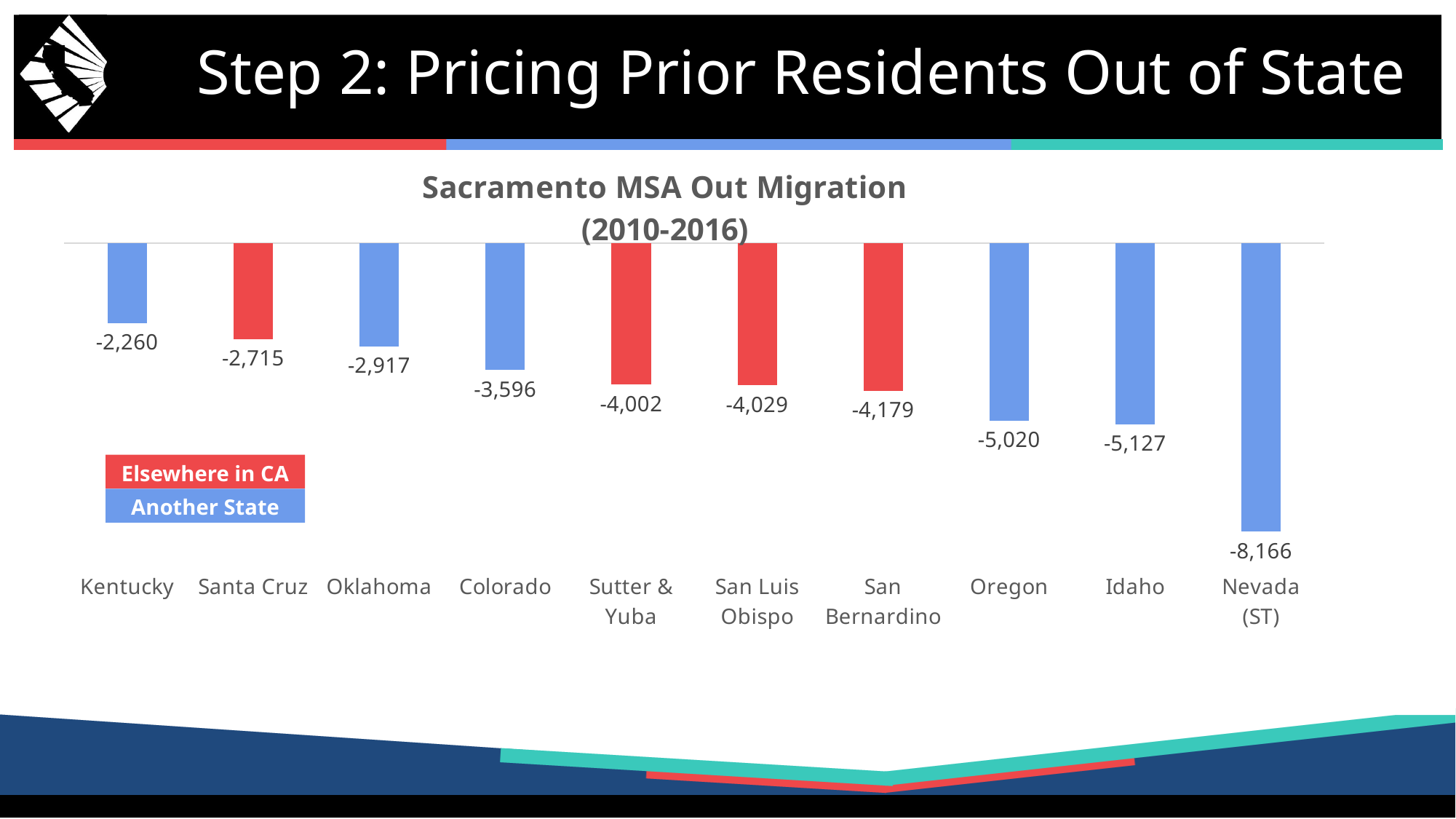
Which legend entry is shown in red? Elsewhere in CA What is the value shown for Colorado? -3,596 What is the difference between the values for Nevada (ST) and Idaho? 3,039 Which has the larger out-migration, Oregon or Idaho? Idaho Which destination has the most negative (largest) out-migration value? Nevada (ST) What is the difference between the values for Kentucky and Santa Cruz? 455 Which destination has the smallest out-migration (value closest to zero)? Kentucky How many destinations are shown on the x axis? 10 What kind of chart is shown on the slide? Bar chart How many series does the legend list? 2 What is the value shown for San Luis Obispo? -4,029 What is the value shown for Nevada (ST) in the Sacramento MSA Out Migration chart? -8,166